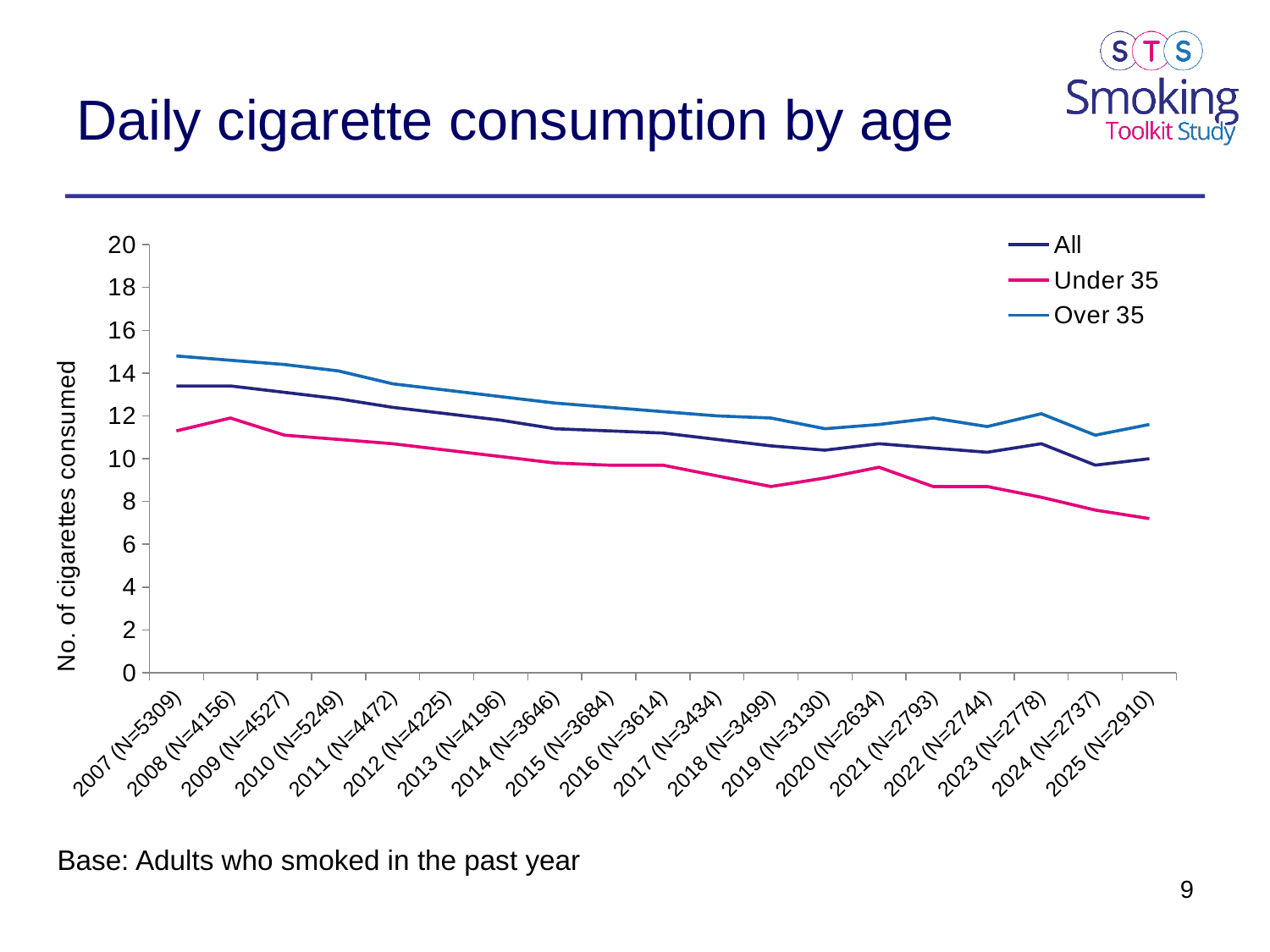
In 2025, which is larger: the value for Over 35 or the value for Under 35? Over 35 What is the title of the y axis? No. of cigarettes consumed Is the value for Over 35 in 2007 greater or less than 14? greater What kind of chart is shown on the slide? Line chart Is the value for Under 35 in 2019 greater or less than 10? less Is the value for Under 35 in 2025 greater or less than 8? less Does the Under 35 line rise or fall overall from 2007 to 2025? Fall How many series does the legend list? 3 In which year is the Under 35 series at its lowest? 2025 How many years are plotted along the x axis? 19 Which series has the highest value in 2007? Over 35